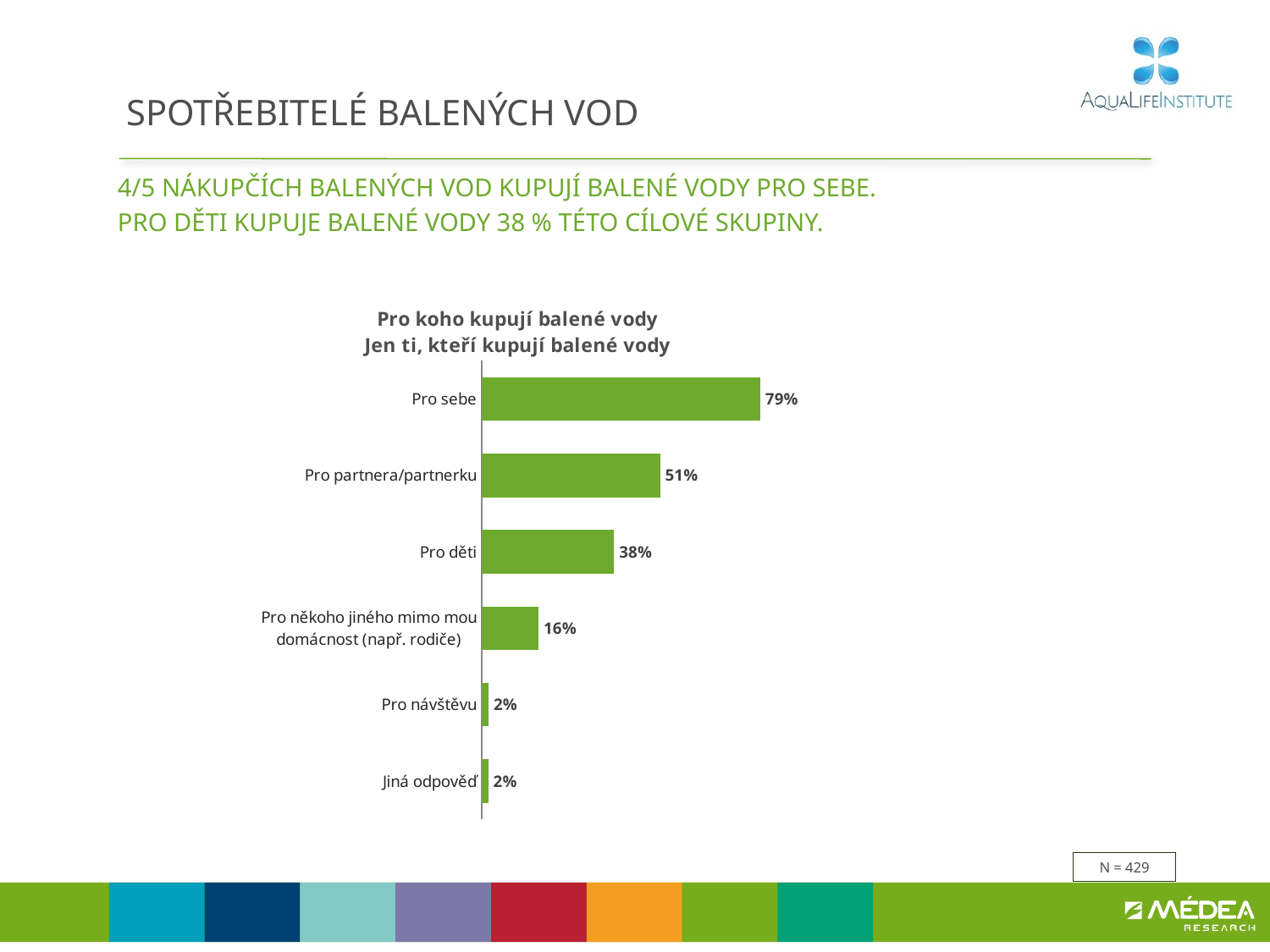
What is the value for "Pro někoho jiného mimo mou domácnost (např. rodiče)"? 16% Which category has the highest value? Pro sebe How many categories are shown in the chart? 6 What kind of chart is shown on the slide? Bar chart What is the value for "Pro návštěvu"? 2% What is the title of the chart? Pro koho kupují balené vody Jen ti, kteří kupují balené vody What is the value for "Pro sebe"? 79% What is the value for "Pro partnera/partnerku"? 51% Which is larger, the value for "Pro partnera/partnerku" or the value for "Pro děti"? Pro partnera/partnerku What is the difference between the values for "Pro děti" and "Pro někoho jiného mimo mou domácnost (např. rodiče)"? 22% What is the value for "Pro děti"? 38% What is the difference between the values for "Pro sebe" and "Pro partnera/partnerku"? 28%